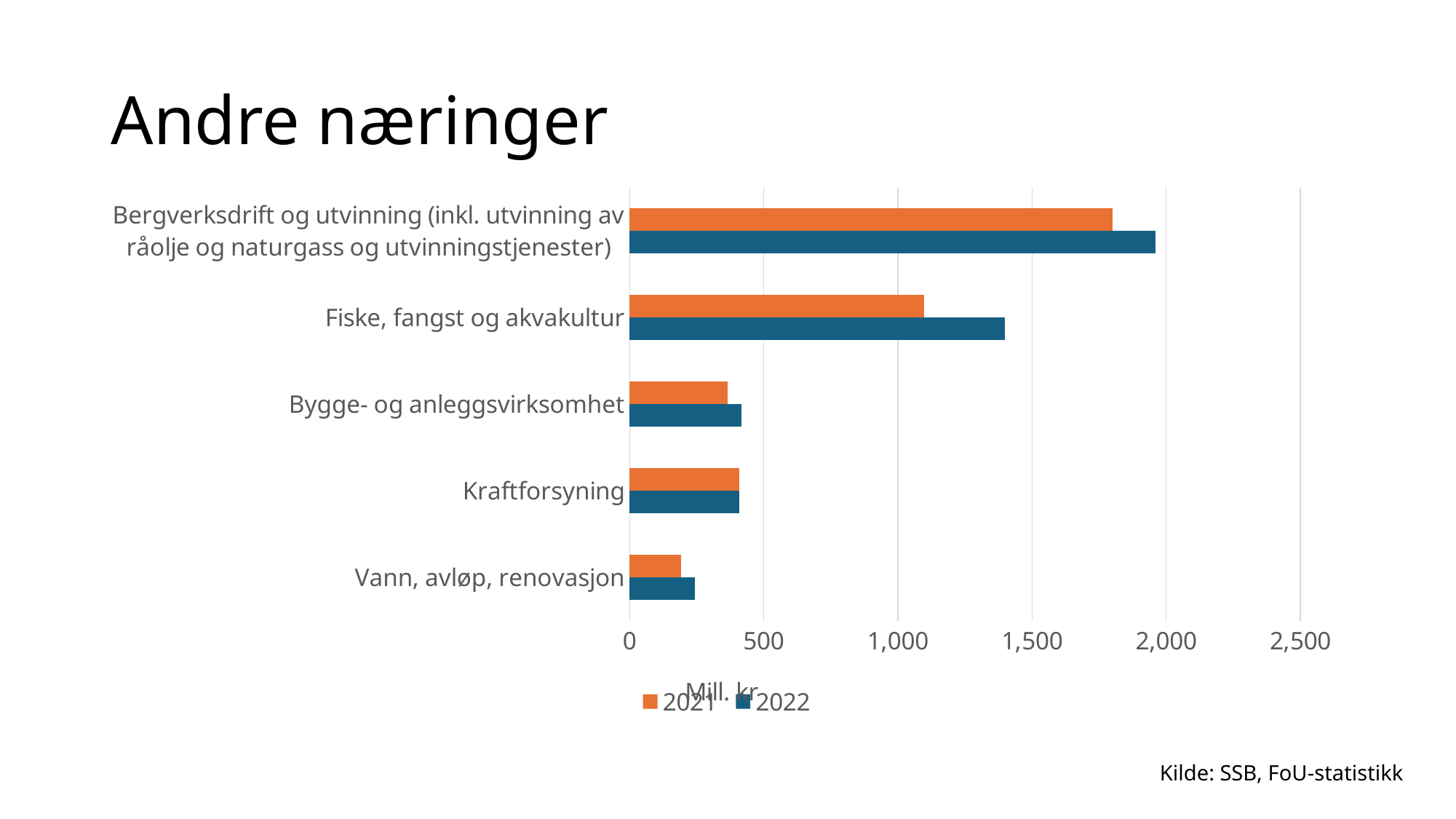
How many series does the legend list? 2 How many categories are shown on the chart? 5 For Fiske, fangst og akvakultur, which year has the larger value, 2021 or 2022? 2022 Which category has the lowest value for 2021? Vann, avløp, renovasjon Which category has the highest value for 2022? Bergverksdrift og utvinning (inkl. utvinning av råolje og naturgass og utvinningstjenester) Is the 2022 value for Bergverksdrift og utvinning greater or less than 1,500? greater Is the 2021 value for Vann, avløp, renovasjon greater or less than 500? less What unit is shown on the x axis? Mill. kr Is the 2021 value for Bygge- og anleggsvirksomhet greater or less than 500? less What is the title of the chart? Andre næringer What kind of chart is shown on the slide? bar chart